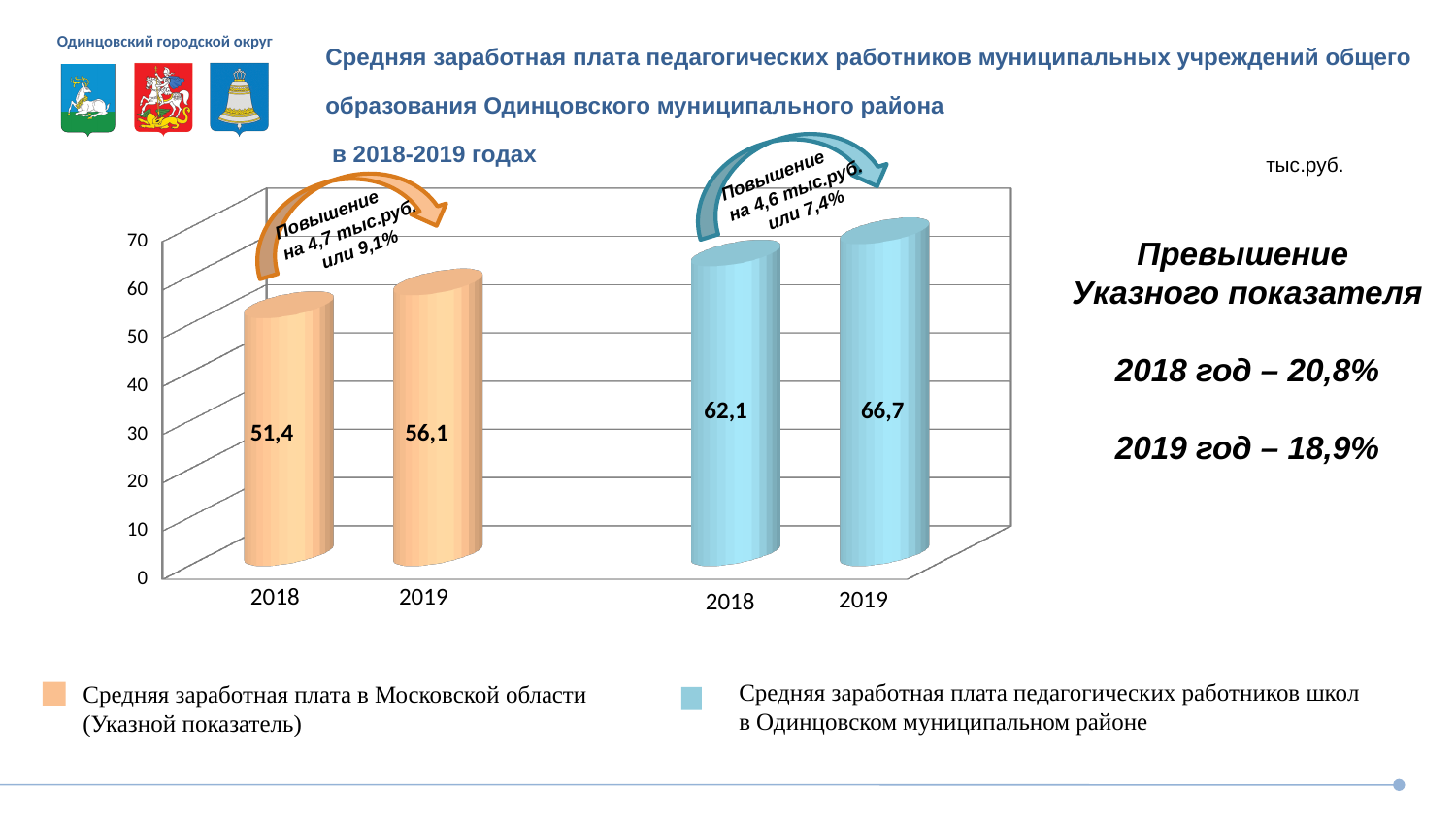
What is the difference between the 2019 and 2018 values for the Odintsovo teachers' salary series (blue bars)? 4,6 What is the value for 2019 in the series 'Средняя заработная плата педагогических работников школ в Одинцовском муниципальном районе'? 66,7 What kind of chart is shown on the slide? Bar chart What is the difference between the 2019 and 2018 values for the Moscow region series (orange bars)? 4,7 Do the values of the blue series rise or fall from 2018 to 2019? Rise Which is larger in 2018: the Moscow region value (orange) or the Odintsovo teachers' value (blue)? Odintsovo teachers' value (62,1) How many series does the legend list? 2 Which bar has the highest value on the chart? 2019, Средняя заработная плата педагогических работников школ в Одинцовском муниципальном районе (66,7) What is the value for 2019 in the series 'Средняя заработная плата в Московской области (Указной показатель)'? 56,1 What is the value for 2018 in the series 'Средняя заработная плата в Московской области (Указной показатель)'? 51,4 Which bar has the lowest value on the chart? 2018, Средняя заработная плата в Московской области (Указной показатель) (51,4) What is the value for 2018 in the series 'Средняя заработная плата педагогических работников школ в Одинцовском муниципальном районе'? 62,1